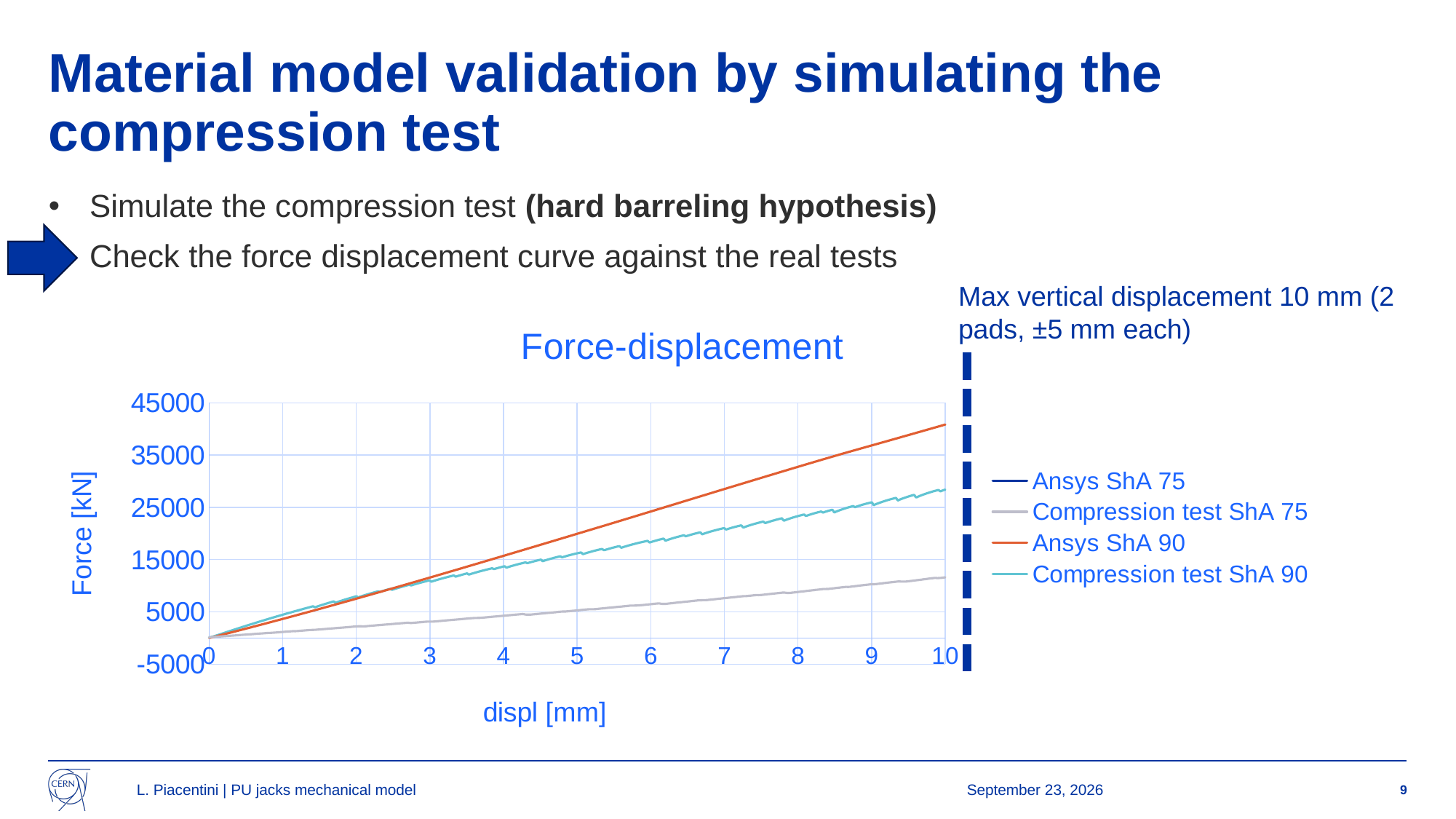
What is the title of the chart? Force-displacement At a displacement of 10 mm, is the value for Compression test ShA 75 greater or less than 15000? less How many series does the chart legend list? 4 What kind of chart is shown on the slide? line chart At a displacement of 10 mm, is the value for Compression test ShA 90 greater or less than 35000? less Which series reaches the highest force at a displacement of 10 mm? Ansys ShA 90 At a displacement of 10 mm, which series has the higher force: Ansys ShA 90 or Compression test ShA 90? Ansys ShA 90 At a displacement of 5 mm, is the value for Ansys ShA 90 greater or less than 15000? greater What is the label of the y axis of the chart? Force [kN] Do the force values rise or fall as displacement increases along the x axis? rise At a displacement of 10 mm, which series has the higher force: Compression test ShA 90 or Compression test ShA 75? Compression test ShA 90